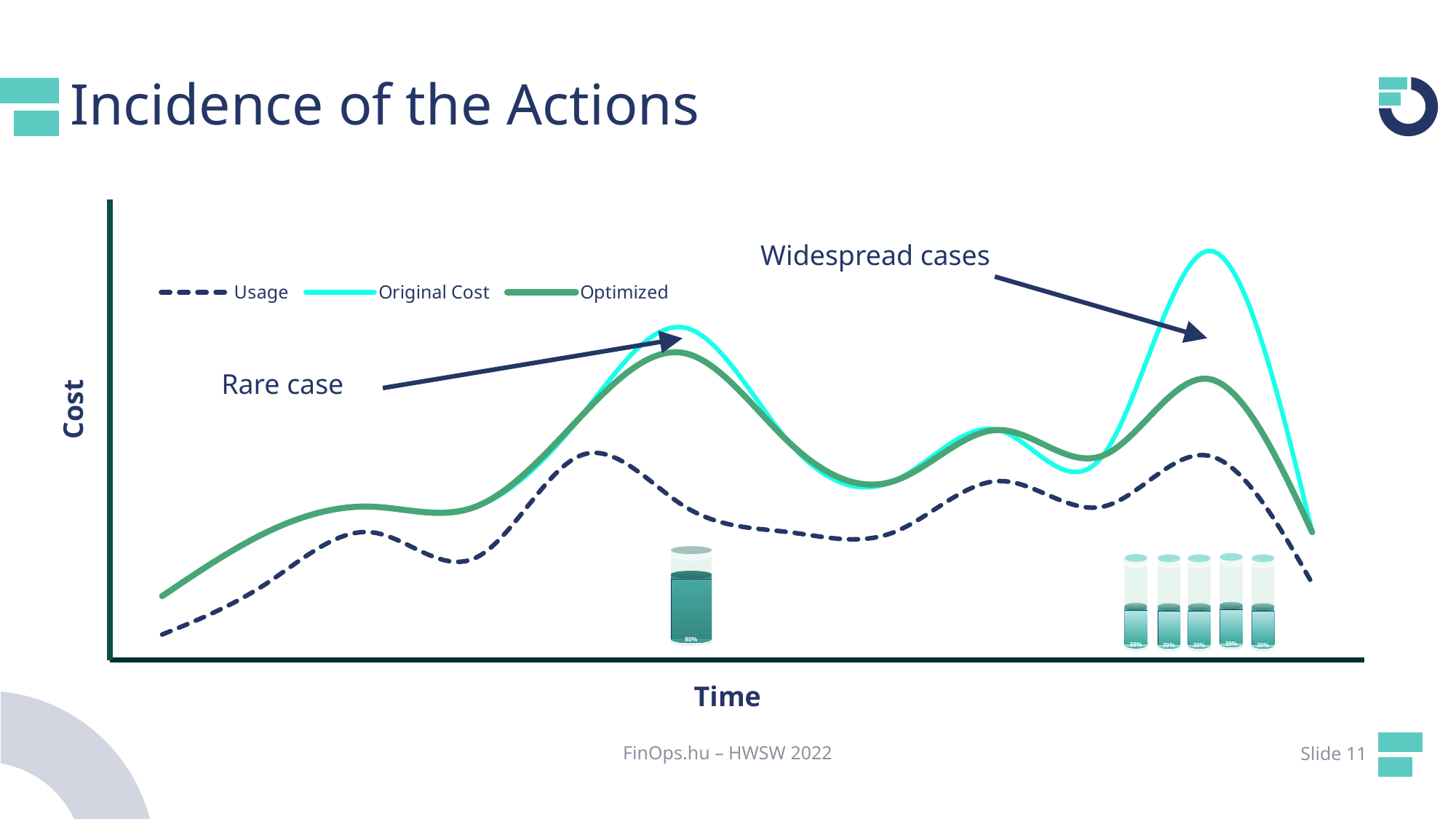
What kind of chart is shown on the slide? Line chart Which series is higher at the far left of the chart: Optimized or Usage? Optimized Which series reaches the highest point on the chart? Original Cost Which series in the legend is drawn as a dashed line? Usage At the tallest peak on the right side of the chart, which is higher: Original Cost or Optimized? Original Cost Which series stays lowest across the chart? Usage What is the label on the vertical axis of the chart? Cost How many series does the chart's legend list? 3 At the peak labelled 'Rare case', which is higher: Optimized or Usage? Optimized Does the Original Cost line rise or fall at the far right end of the chart? Fall